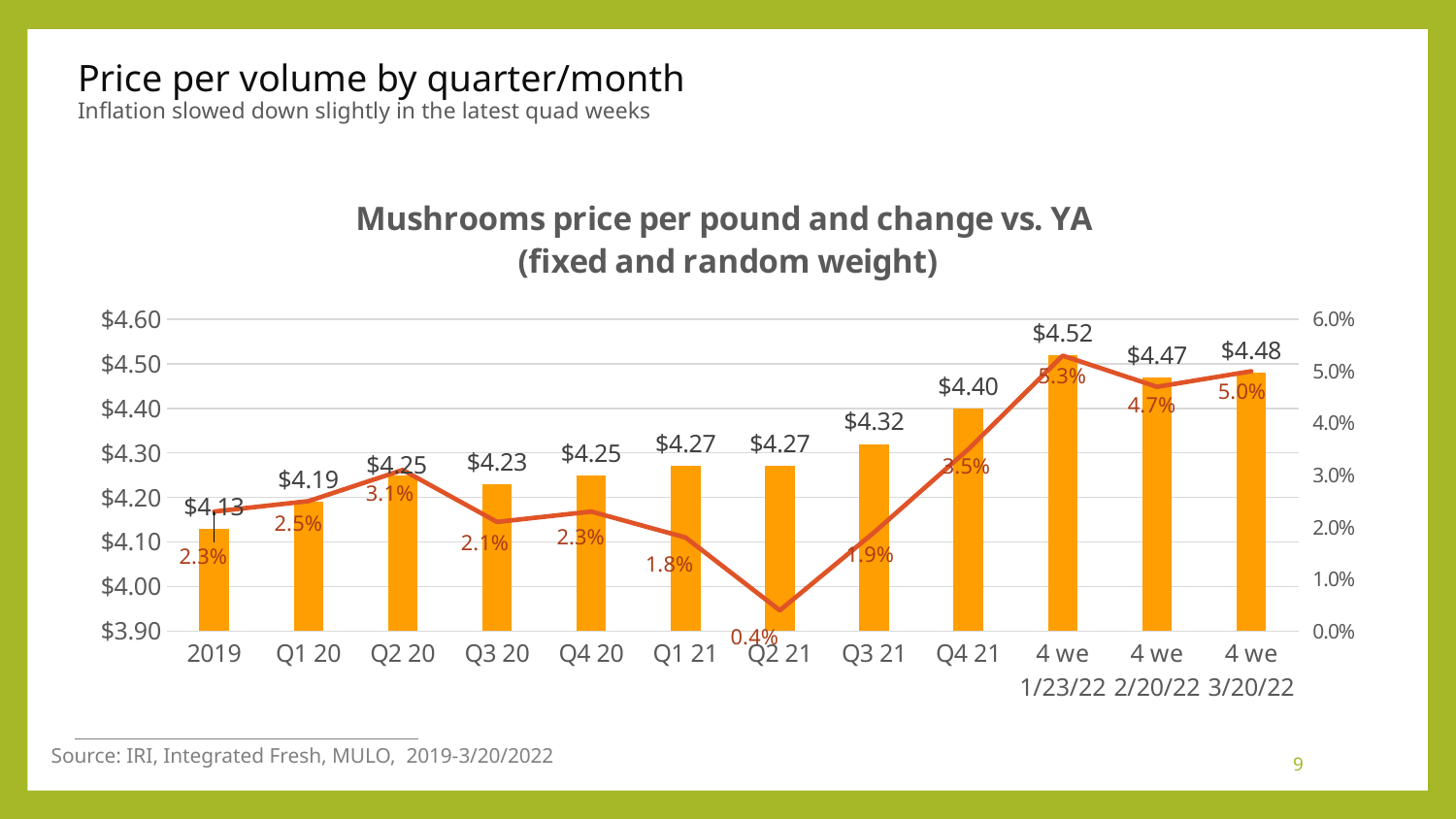
Does the price per pound generally rise or fall from 2019 to 4 we 1/23/22? Rise What is the mushrooms price per pound for Q4 21? $4.40 Is the change vs. YA for 4 we 3/20/22 greater or less than 4.0%? greater What is the change vs. YA shown for Q2 21? 0.4% Which period has the lowest price per pound? 2019 Which period has the lowest change vs. YA? Q2 21 Which is higher, the price per pound in Q3 21 or in Q4 21? Q4 21 What kind of chart is this? Combination bar and line chart How many periods are shown on the x axis? 12 What is the price per pound for the 4 weeks ending 2/20/22? $4.47 What is the difference in price per pound between 4 we 1/23/22 and 2019? $0.39 Which period has the highest price per pound? 4 we 1/23/22